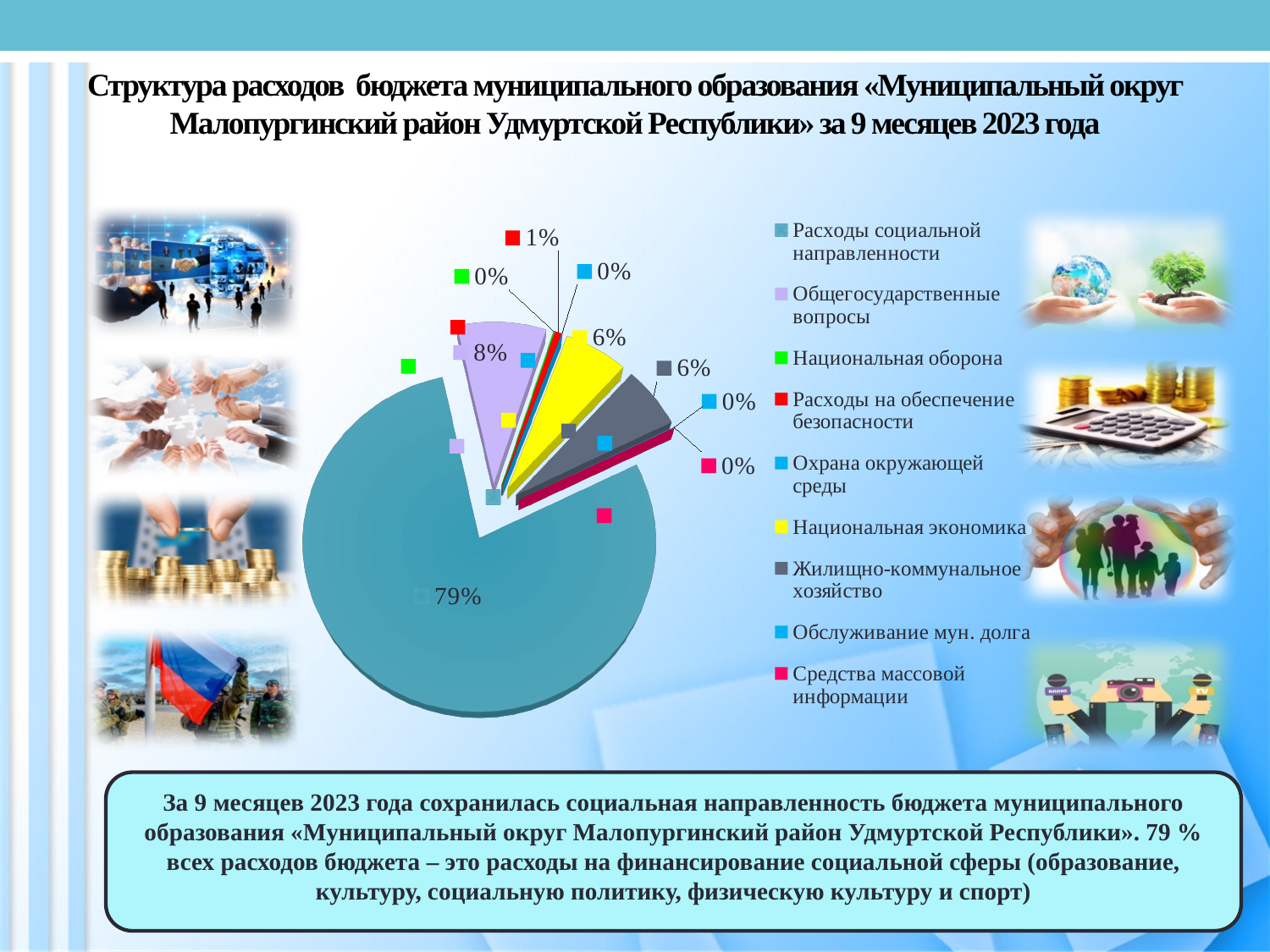
What share is shown for «Национальная оборона»? 0% What kind of chart is shown on the slide? pie chart How many categories does the legend of the pie chart list? 9 What share is shown for «Расходы на обеспечение безопасности»? 1% What share is shown for «Национальная экономика»? 6% Which is larger: the share for «Общегосударственные вопросы» or the share for «Национальная экономика»? Общегосударственные вопросы What colour is the slice for «Национальная экономика» in the pie chart? yellow What share of the budget expenditures is labelled for «Расходы социальной направленности»? 79% What share is shown for «Общегосударственные вопросы»? 8% What share is shown for «Жилищно-коммунальное хозяйство»? 6% Which category has the largest share of the pie? Расходы социальной направленности What is the difference in percentage points between «Расходы социальной направленности» and «Общегосударственные вопросы»? 71%